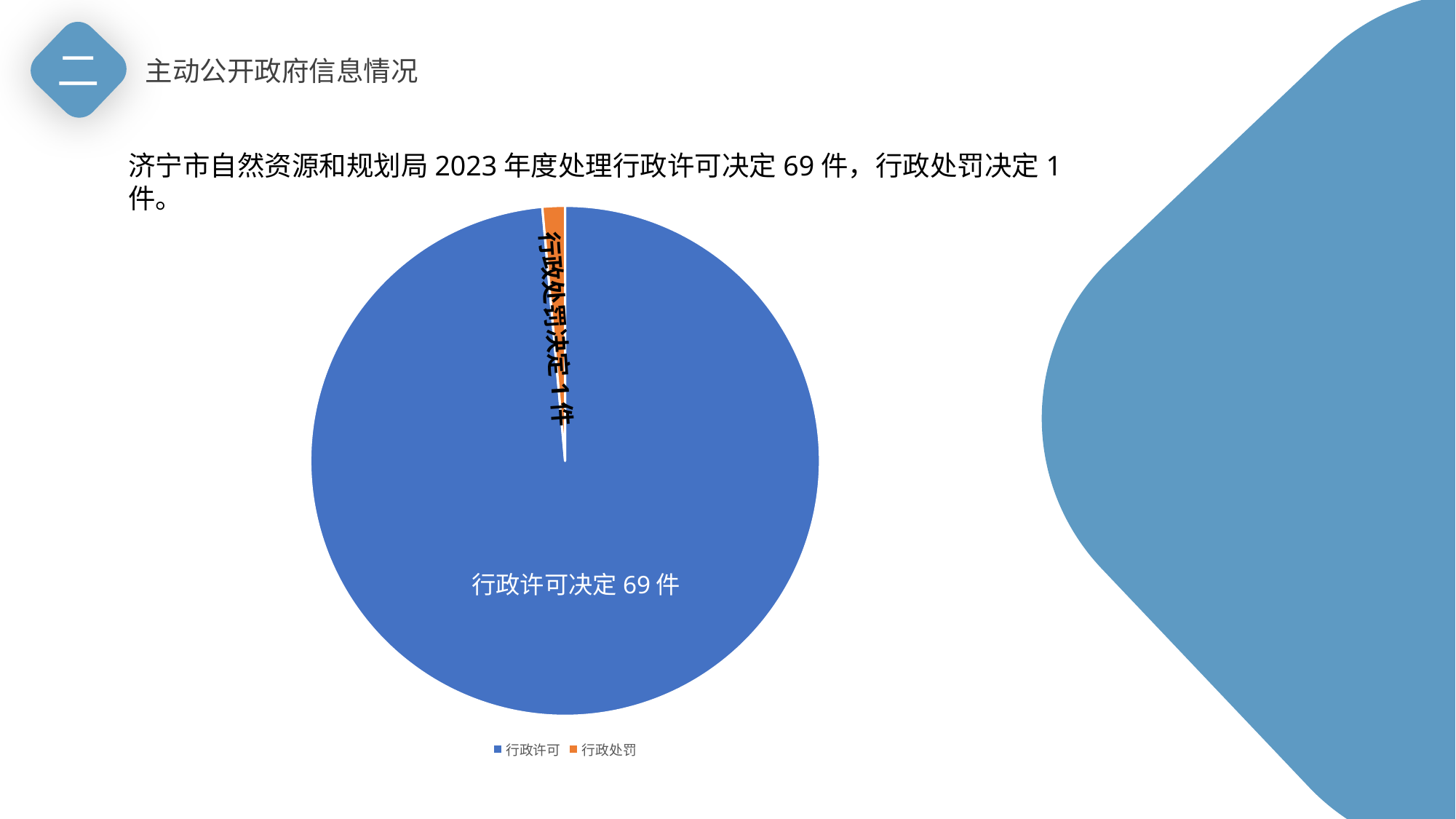
Which slice of the pie chart is the smallest? 行政处罚决定 What is the value shown for 行政许可决定 in the pie chart? 69 件 How many slices does the pie chart have? 2 What is the difference between the number of 行政许可决定 and 行政处罚决定? 68 件 How many entries does the legend of the pie chart list? 2 What is the total number of decisions shown in the pie chart? 70 件 Which slice of the pie chart is the largest? 行政许可决定 What colour is the 行政处罚 slice in the pie chart? orange What is the value shown for 行政处罚决定 in the pie chart? 1 件 What type of chart is shown on the slide? pie chart What are the two legend entries of the pie chart? 行政许可, 行政处罚 Which is larger, 行政许可决定 or 行政处罚决定? 行政许可决定